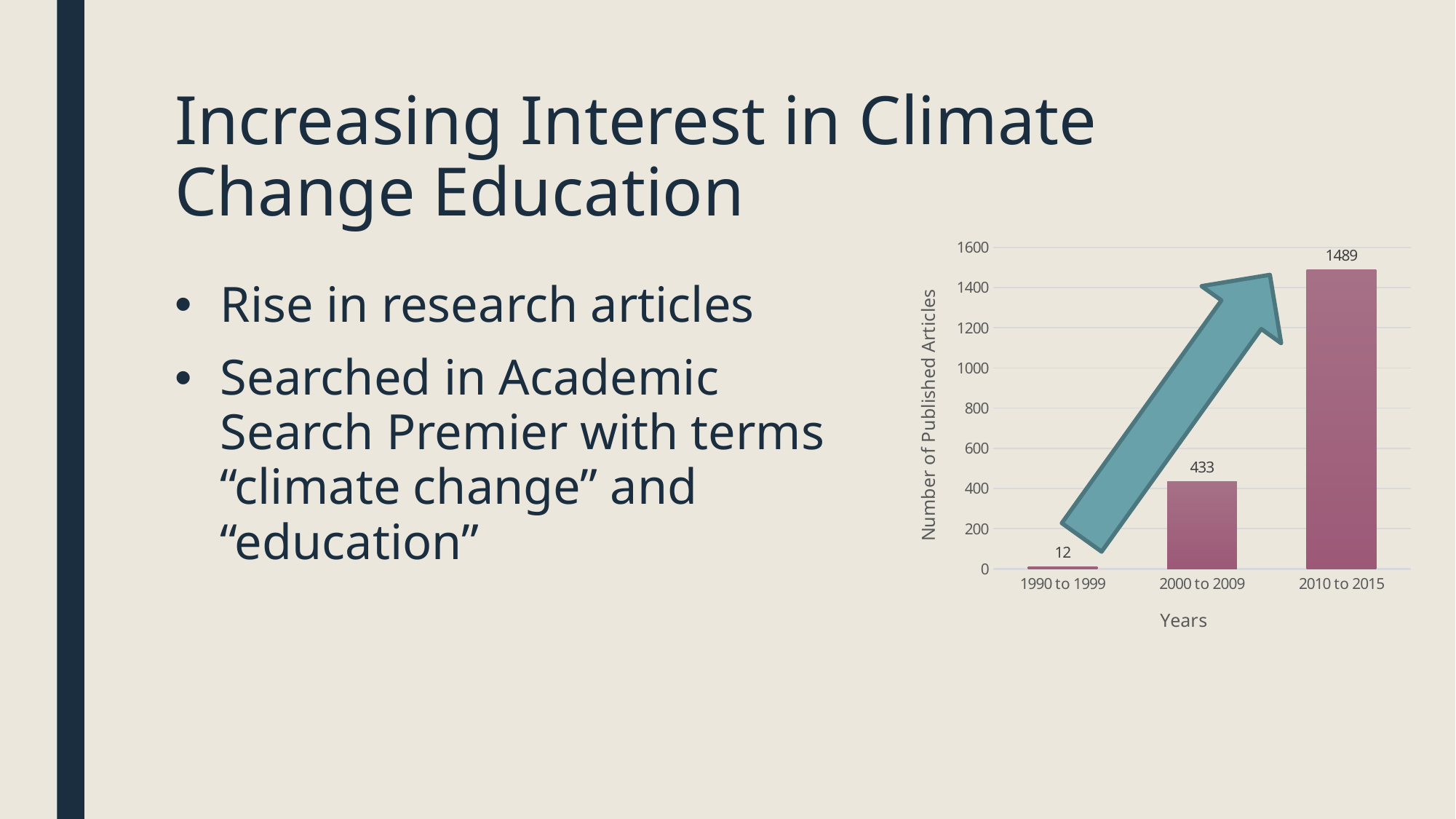
Which period has the highest number of published articles? 2010 to 2015 What is the difference in published articles between 2000 to 2009 and 1990 to 1999? 421 Which period has the lowest number of published articles? 1990 to 1999 How many periods are shown on the x axis of the chart? 3 What is the number of published articles for 1990 to 1999? 12 Which period has more published articles, 2000 to 2009 or 1990 to 1999? 2000 to 2009 What is the number of published articles for 2010 to 2015? 1489 Do the values rise or fall from 1990 to 1999 through 2010 to 2015? Rise What kind of chart is shown on the slide? Bar chart What is the number of published articles for 2000 to 2009? 433 Is the value for 2010 to 2015 greater or less than 1400? greater What is the difference in published articles between 2010 to 2015 and 2000 to 2009? 1056